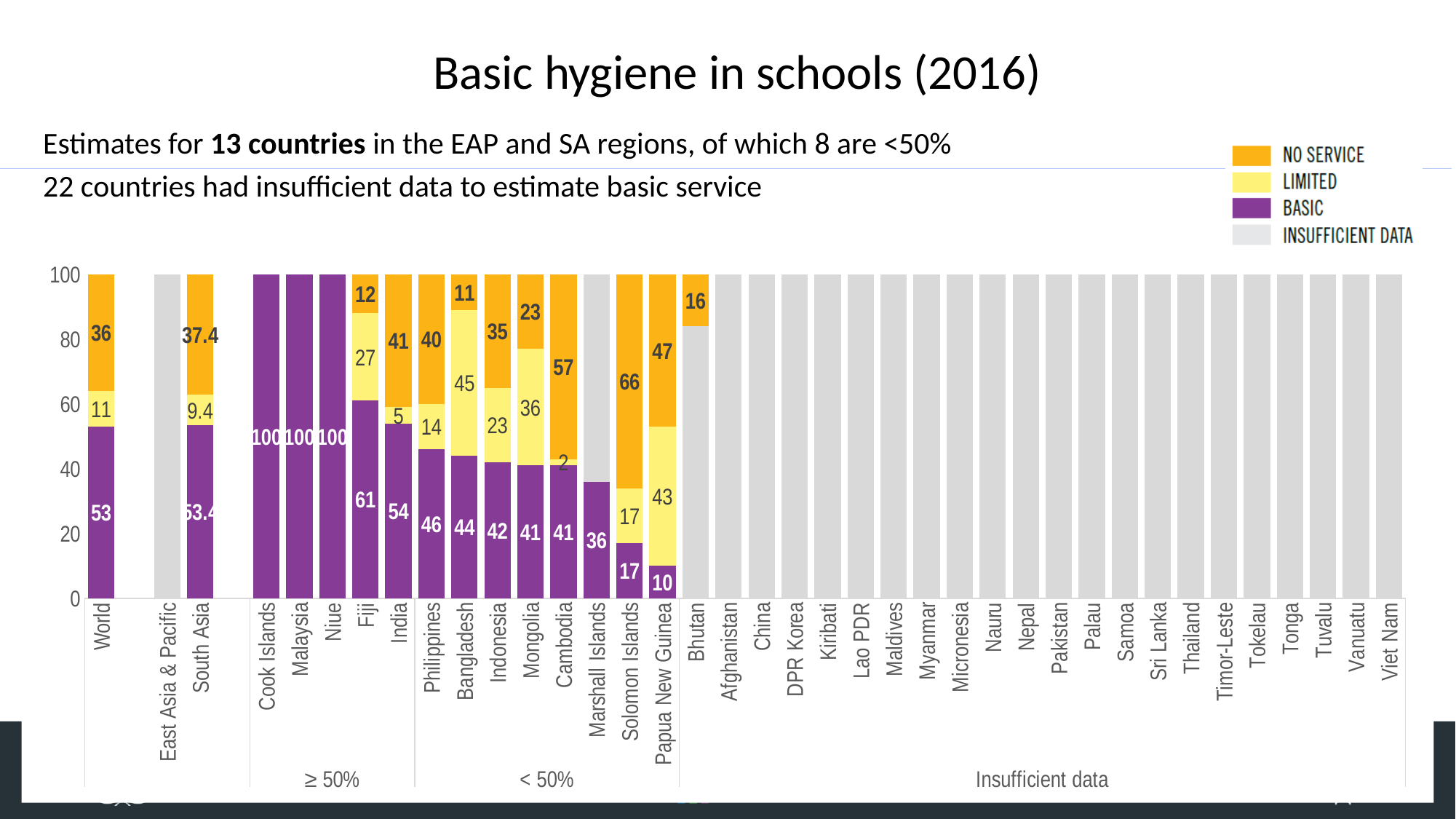
Among the countries with a labelled BASIC value, which has the lowest BASIC value? Papua New Guinea What is the LIMITED value for Bangladesh? 45 Which has a larger BASIC value, Fiji or India? Fiji What is the BASIC value for Fiji? 61 What is the difference between the BASIC value for World and the BASIC value for Papua New Guinea? 43 What is the NO SERVICE value for Solomon Islands? 66 What is the NO SERVICE value for South Asia? 37.4 How many series does the legend list? 4 How many countries have a BASIC value of 100? 3 Which country has the highest NO SERVICE value? Solomon Islands What colour represents BASIC in the legend? Purple What kind of chart is shown on the slide? Stacked bar chart